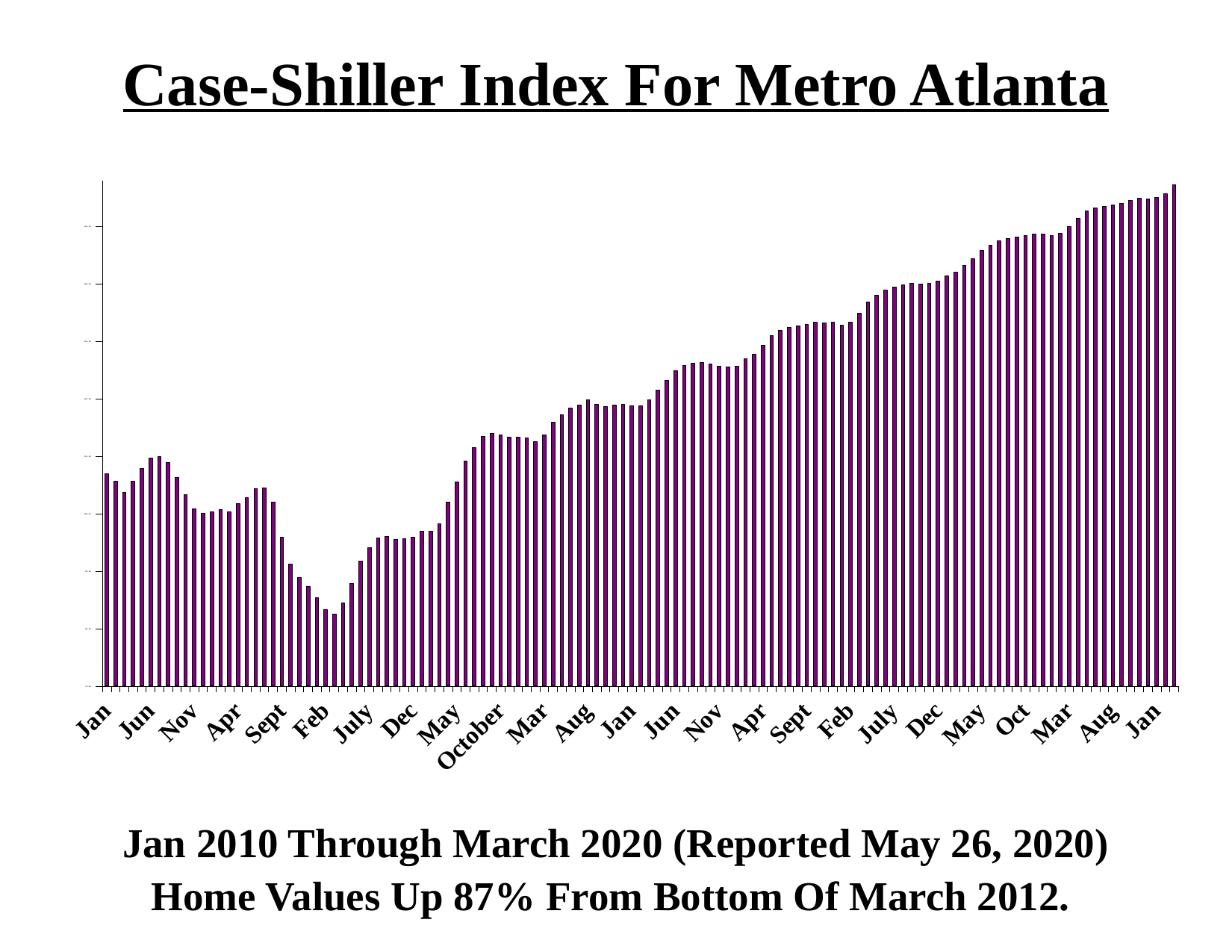
Is the bar at the first 'Jun' label higher or lower than the first bar (Jan)? higher What is the title of the chart? Case-Shiller Index For Metro Atlanta Is the highest bar at the left end or the right end of the chart? right end Is the first bar (Jan) higher or lower than the last bar on the right? lower Overall, do the values rise or fall from the left of the x axis to the right? rise What kind of chart is shown on the slide? bar chart Is the lowest bar in the left half or the right half of the chart? left half According to the slide text, by what percentage are home values up from the bottom of March 2012? 87% Between the first 'Sept' label and the following 'Feb' label, do the values rise or fall? fall